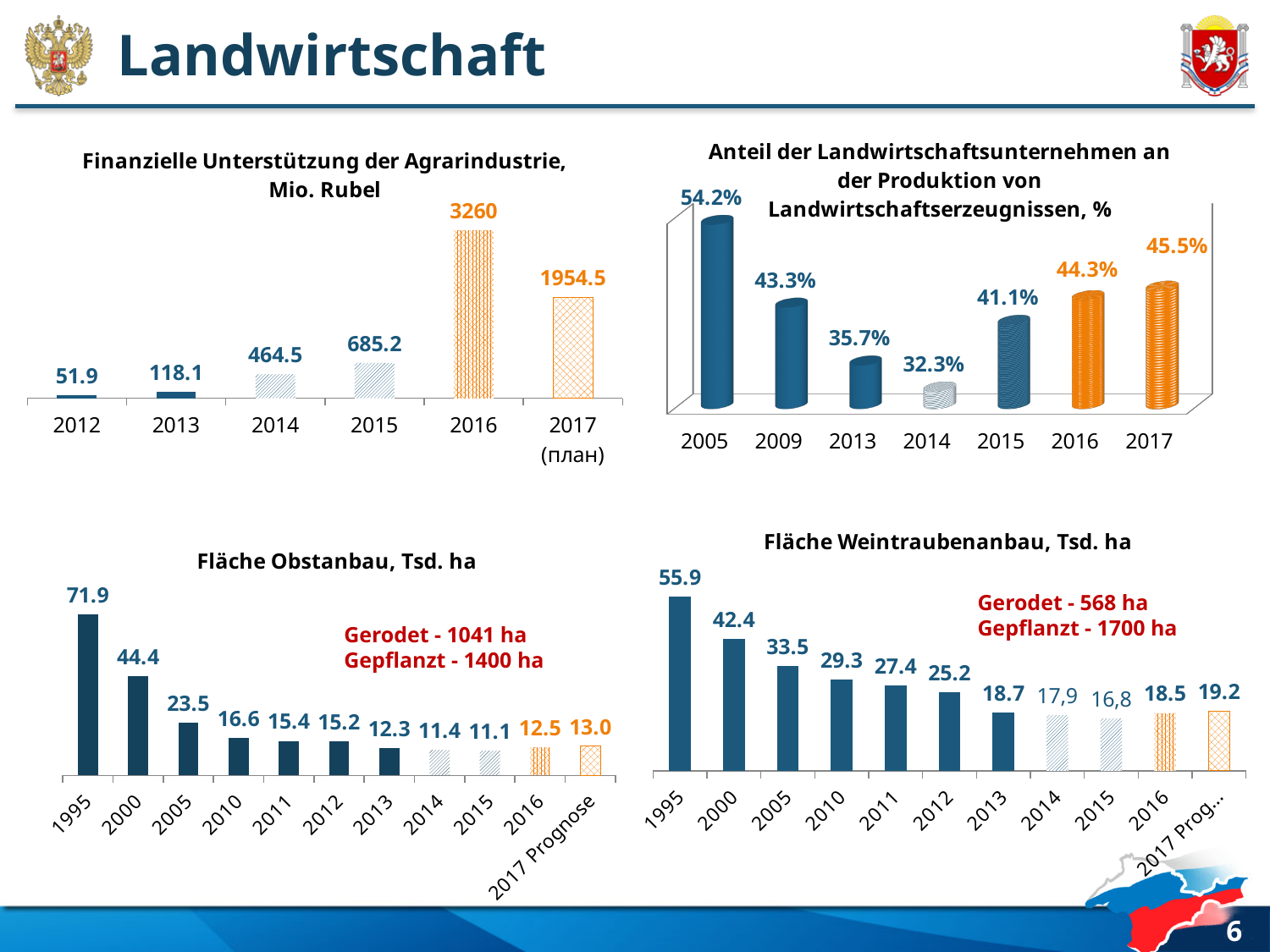
In the chart 'Fläche Obstanbau, Tsd. ha', what is the difference between the values for 1995 and 2000? 27.5 In the chart 'Fläche Weintraubenanbau, Tsd. ha', which is larger, the value for 2010 or the value for 2012? 2010 In the chart 'Anteil der Landwirtschaftsunternehmen an der Produktion von Landwirtschaftserzeugnissen, %', how many years are shown? 7 What kind of chart is 'Fläche Weintraubenanbau, Tsd. ha'? Bar chart In the chart 'Anteil der Landwirtschaftsunternehmen an der Produktion von Landwirtschaftserzeugnissen, %', which year has the highest value? 2005 In the chart 'Anteil der Landwirtschaftsunternehmen an der Produktion von Landwirtschaftserzeugnissen, %', what is the value for 2014? 32.3% In the chart 'Fläche Obstanbau, Tsd. ha', what is the value for 2005? 23.5 In the chart 'Finanzielle Unterstützung der Agrarindustrie, Mio. Rubel', which year has the lowest value? 2012 In the chart 'Finanzielle Unterstützung der Agrarindustrie, Mio. Rubel', what is the value for 2016? 3260 In the chart 'Finanzielle Unterstützung der Agrarindustrie, Mio. Rubel', what is the difference between the values for 2016 and 2017 (план)? 1305.5 In the chart 'Fläche Weintraubenanbau, Tsd. ha', what is the value for 2013? 18.7 In the chart 'Fläche Obstanbau, Tsd. ha', which year has the lowest value? 2015